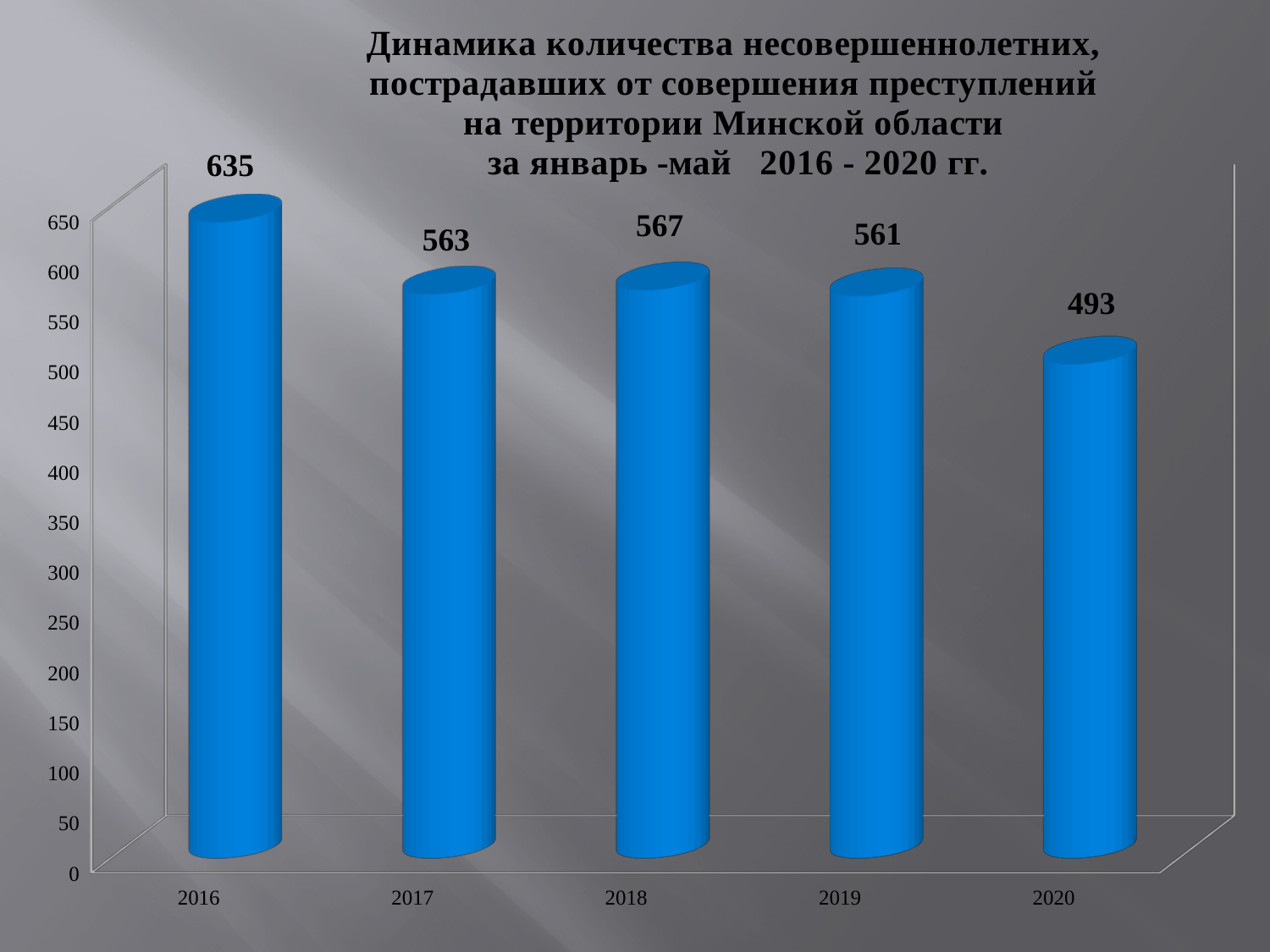
Which year has the lowest value? 2020 What is the value for 2016? 635 What is the difference between the values for 2016 and 2020? 142 Which is larger, the value for 2018 or the value for 2019? 2018 What is the value for 2019? 561 What kind of chart is shown on the slide? Bar chart What is the value for 2020? 493 What is the value for 2018? 567 Which year has the highest value? 2016 Do the values generally rise or fall from 2016 to 2020? Fall How many years are shown on the x axis? 5 What is the value for 2017? 563